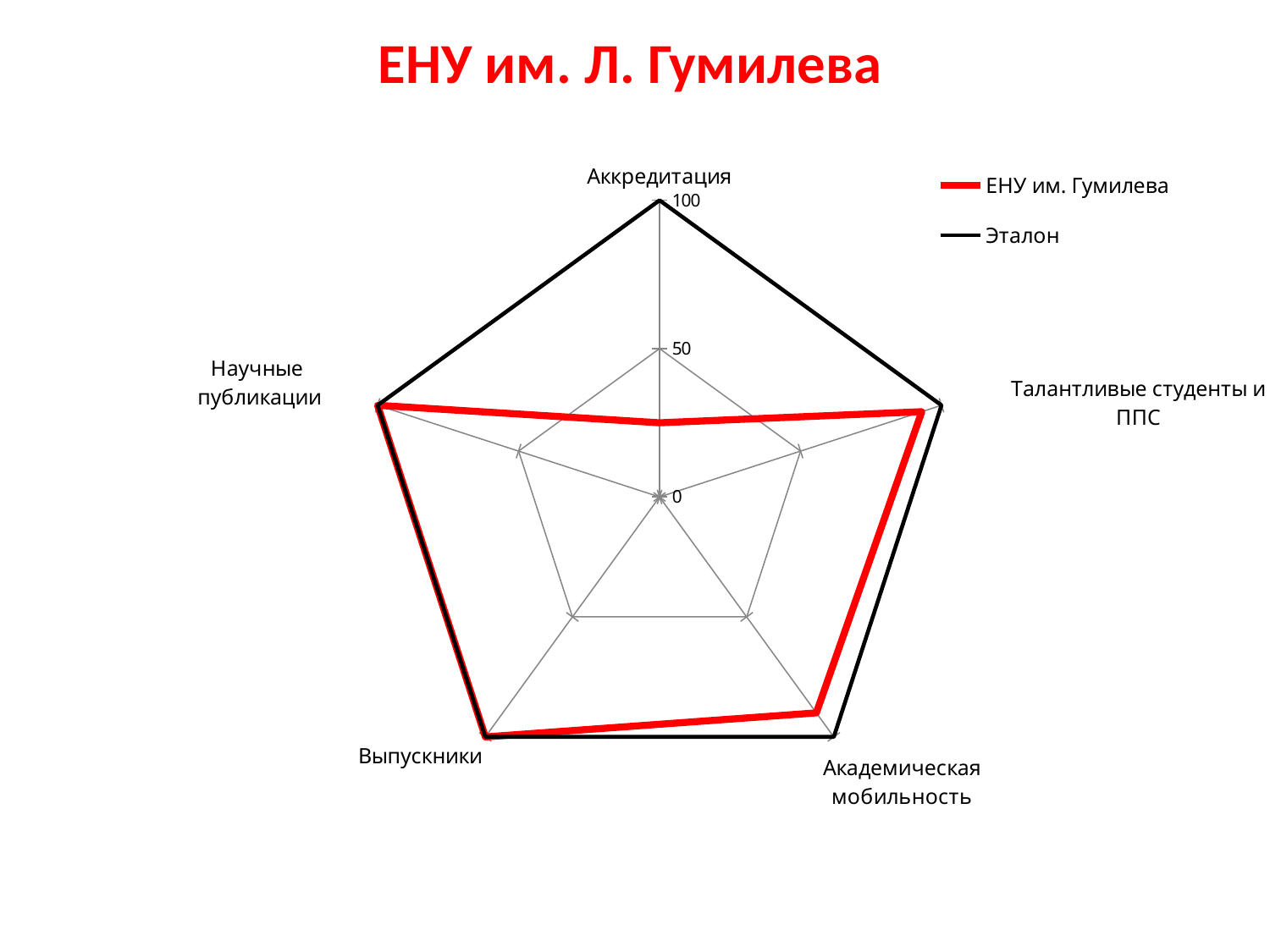
How many series does the legend list? 2 Is the value for Аккредитация in the ЕНУ им. Гумилева series greater or less than 50? less What colour is the line for the ЕНУ им. Гумилева series? red Which category has the lowest value for the ЕНУ им. Гумилева series? Аккредитация What is the value of the Эталон series for Аккредитация? 100 Is the value for Научные публикации in the ЕНУ им. Гумилева series greater or less than 50? greater Is the value for Академическая мобильность in the ЕНУ им. Гумилева series greater or less than 50? greater How many categories (axes) does the radar chart have? 5 What kind of chart is shown on the slide? radar chart What is the maximum value shown on the chart's axis scale? 100 For the ЕНУ им. Гумилева series, which is larger: Аккредитация or Выпускники? Выпускники